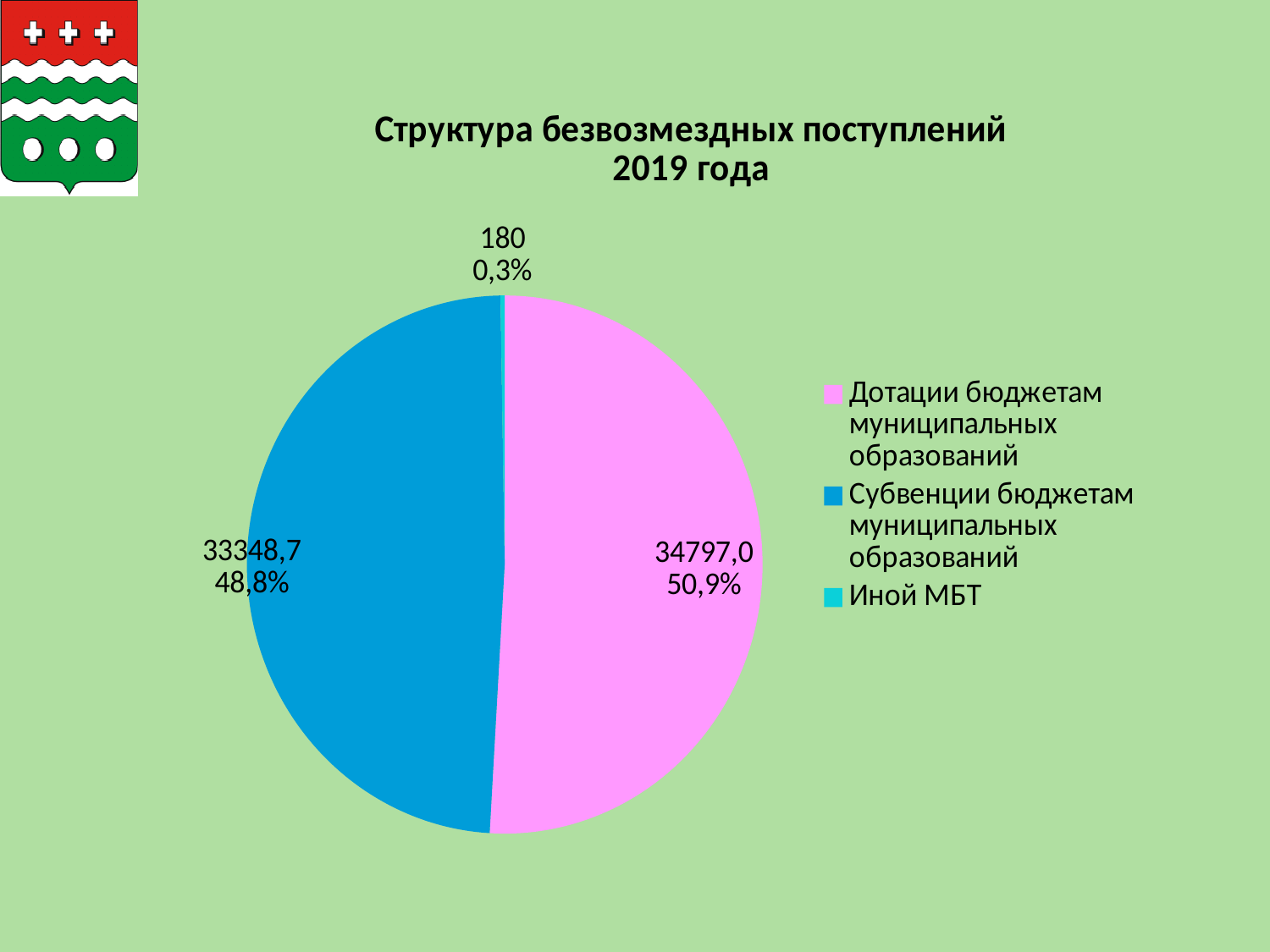
Which category has the largest slice? Дотации бюджетам муниципальных образований How many slices does the pie chart have? 3 What share of the pie does Иной МБТ represent? 0,3% What is the title of the chart? Структура безвозмездных поступлений 2019 года Which category has the smallest slice? Иной МБТ Which colour represents Субвенции бюджетам муниципальных образований in the legend? blue What is the value for Иной МБТ? 180 What type of chart is shown on the slide? pie chart What share of the pie does Дотации бюджетам муниципальных образований represent? 50,9% What is the value for Субвенции бюджетам муниципальных образований? 33348,7 What is the value for Дотации бюджетам муниципальных образований? 34797,0 What is the difference between the values for Дотации бюджетам муниципальных образований and Субвенции бюджетам муниципальных образований? 1448,3